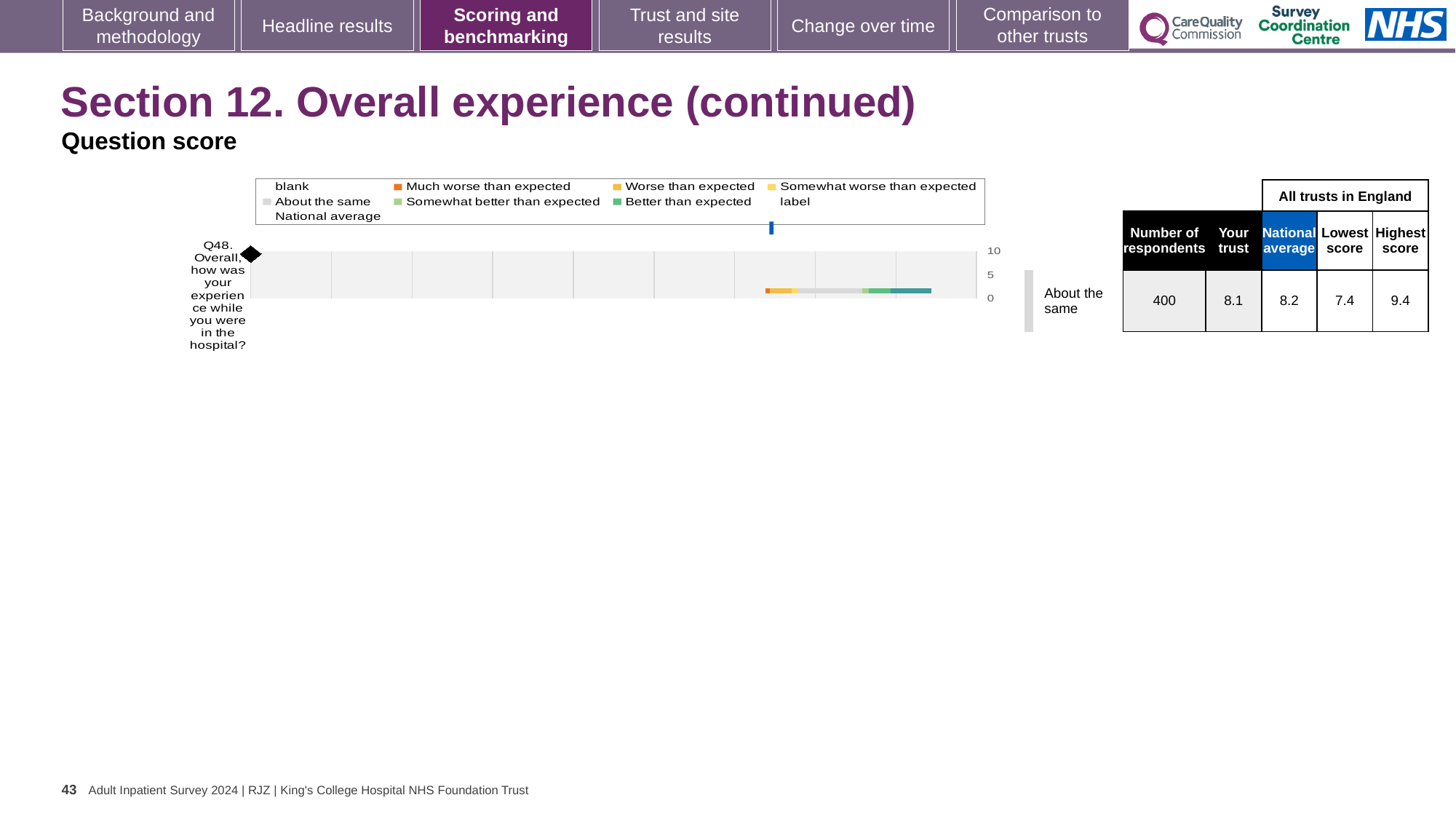
Which is larger for Q48, the 'Your trust' score or the national average? National average In the table next to the chart, what is the national average score for Q48? 8.2 In the table next to the chart, what is the number of respondents for Q48? 400 What kind of chart is shown for Q48 on the slide? bar chart What is the highest tick value shown on the chart's axis? 10 In the table next to the chart, what is the lowest score among all trusts in England for Q48? 7.4 How many questions (categories) are plotted in the chart? 1 In the table next to the chart, what is the 'Your trust' score for Q48? 8.1 In the table next to the chart, what is the highest score among all trusts in England for Q48? 9.4 Which question is plotted in the chart? Q48. Overall, how was your experience while you were in the hospital? What benchmark category is given for Q48 next to the chart? About the same What is the difference between the highest score and the lowest score for Q48 in the table? 2.0